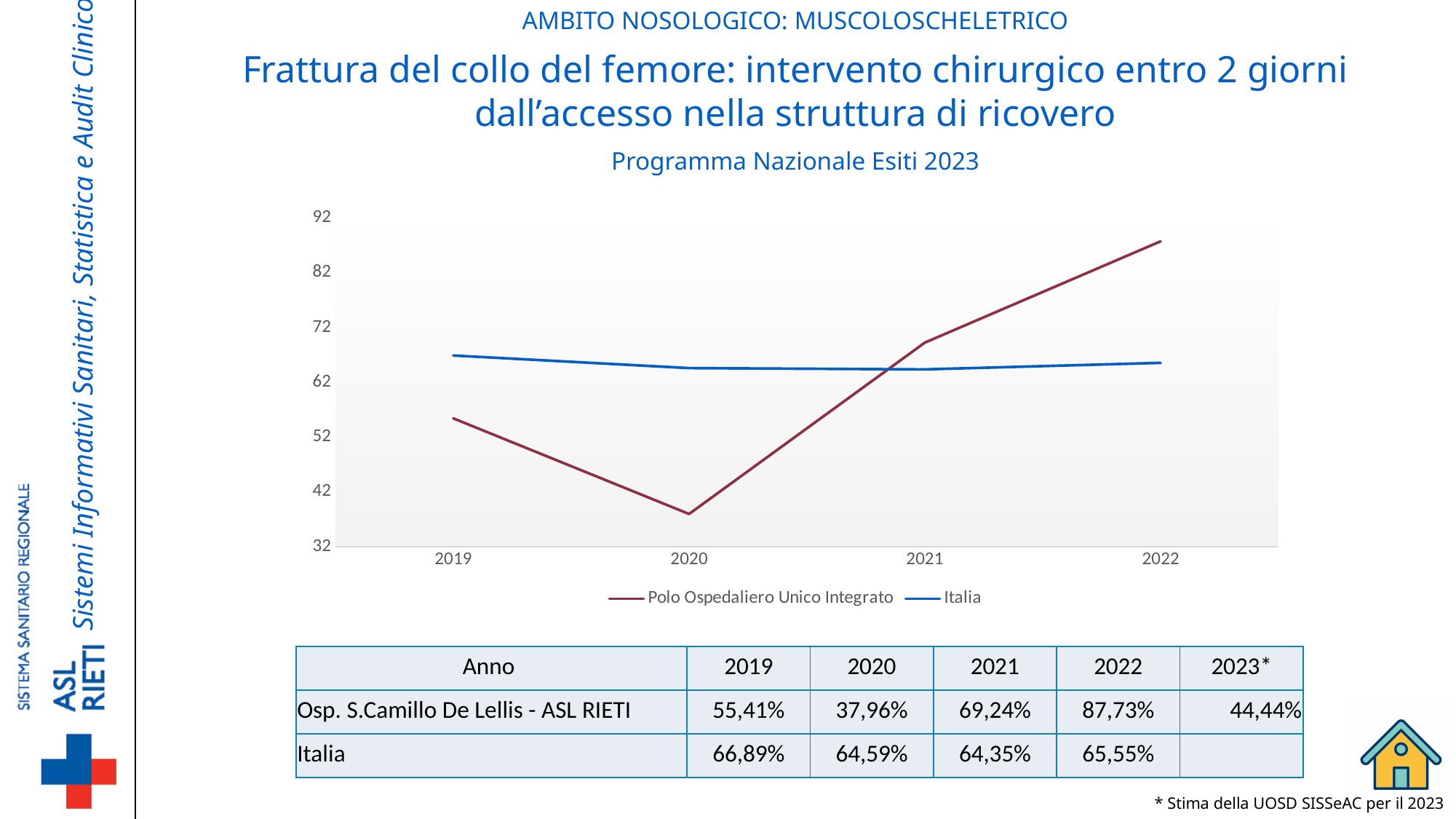
What kind of chart is shown on the slide? line chart In which year does the Polo Ospedaliero Unico Integrato line reach its highest value? 2022 According to the table, what is the value for Italia in 2019? 66,89% In which year does the Polo Ospedaliero Unico Integrato line reach its lowest value? 2020 Is the value for Polo Ospedaliero Unico Integrato in 2020 greater or less than 42? less How many series does the chart legend list? 2 Does the Polo Ospedaliero Unico Integrato line rise or fall from 2020 to 2022? rise In 2021, which series has the higher value: Polo Ospedaliero Unico Integrato or Italia? Polo Ospedaliero Unico Integrato How many years are plotted along the x axis of the chart? 4 According to the table, what is the estimated 2023* value for Osp. S.Camillo De Lellis - ASL RIETI? 44,44% According to the table, what is the value for Osp. S.Camillo De Lellis - ASL RIETI in 2020? 37,96% Using the table values, what is the difference between Osp. S.Camillo De Lellis - ASL RIETI and Italia in 2022? 22,18%